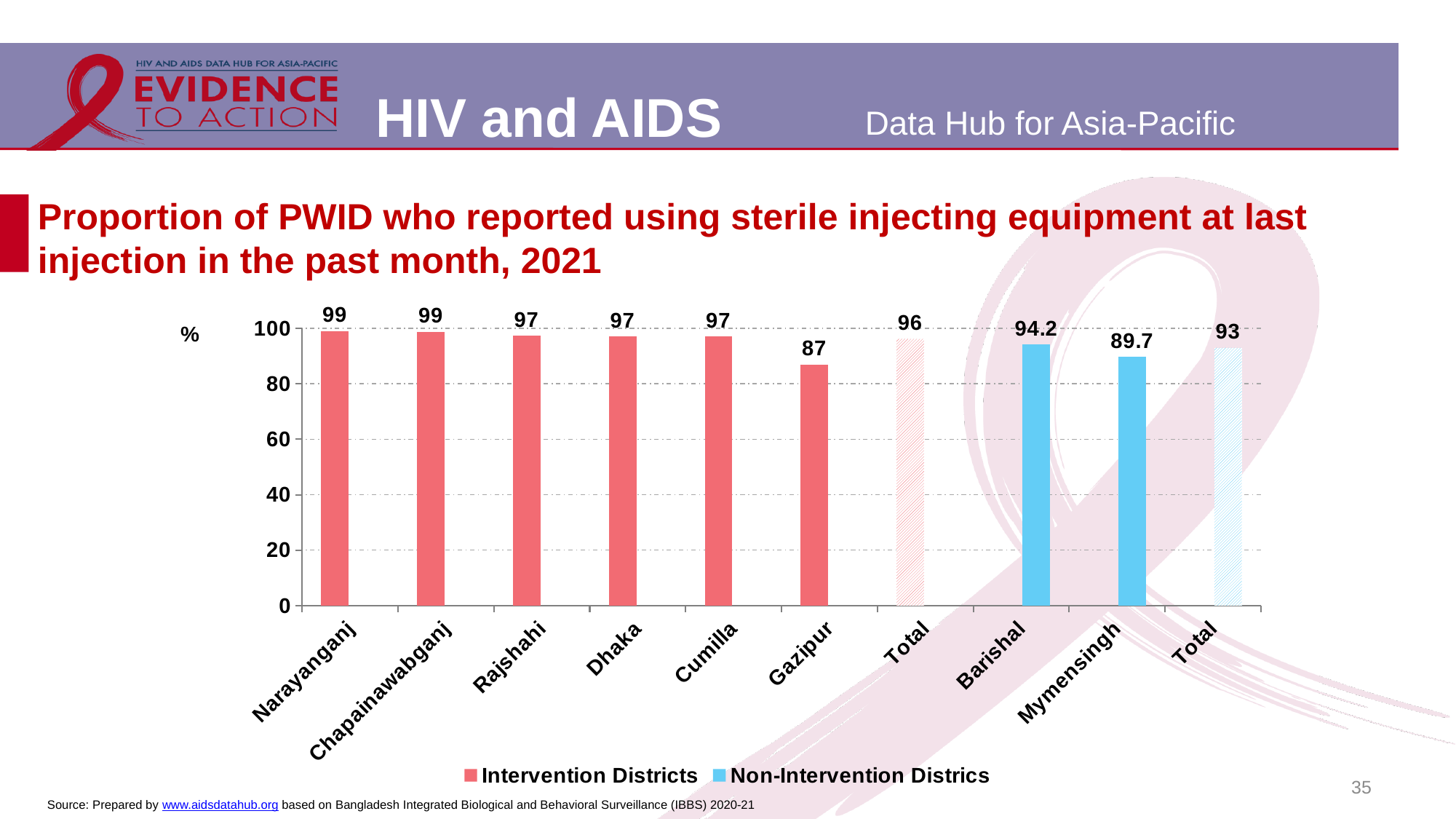
What is the difference between the values for Barishal and Mymensingh? 4.5 What is the value for Barishal? 94.2 How many bars are plotted on the chart? 10 Which is larger, the value for Dhaka or the value for Mymensingh? Dhaka What is the difference between the values for Narayanganj and Gazipur? 12 What is the value of the Total bar for the Non-Intervention Districts? 93 What is the value for Mymensingh? 89.7 Which district has the lowest value on the chart? Gazipur What kind of chart is shown on the slide? Bar chart What is the value of the Total bar for the Intervention Districts? 96 How many series does the legend list? 2 What is the value for Gazipur? 87